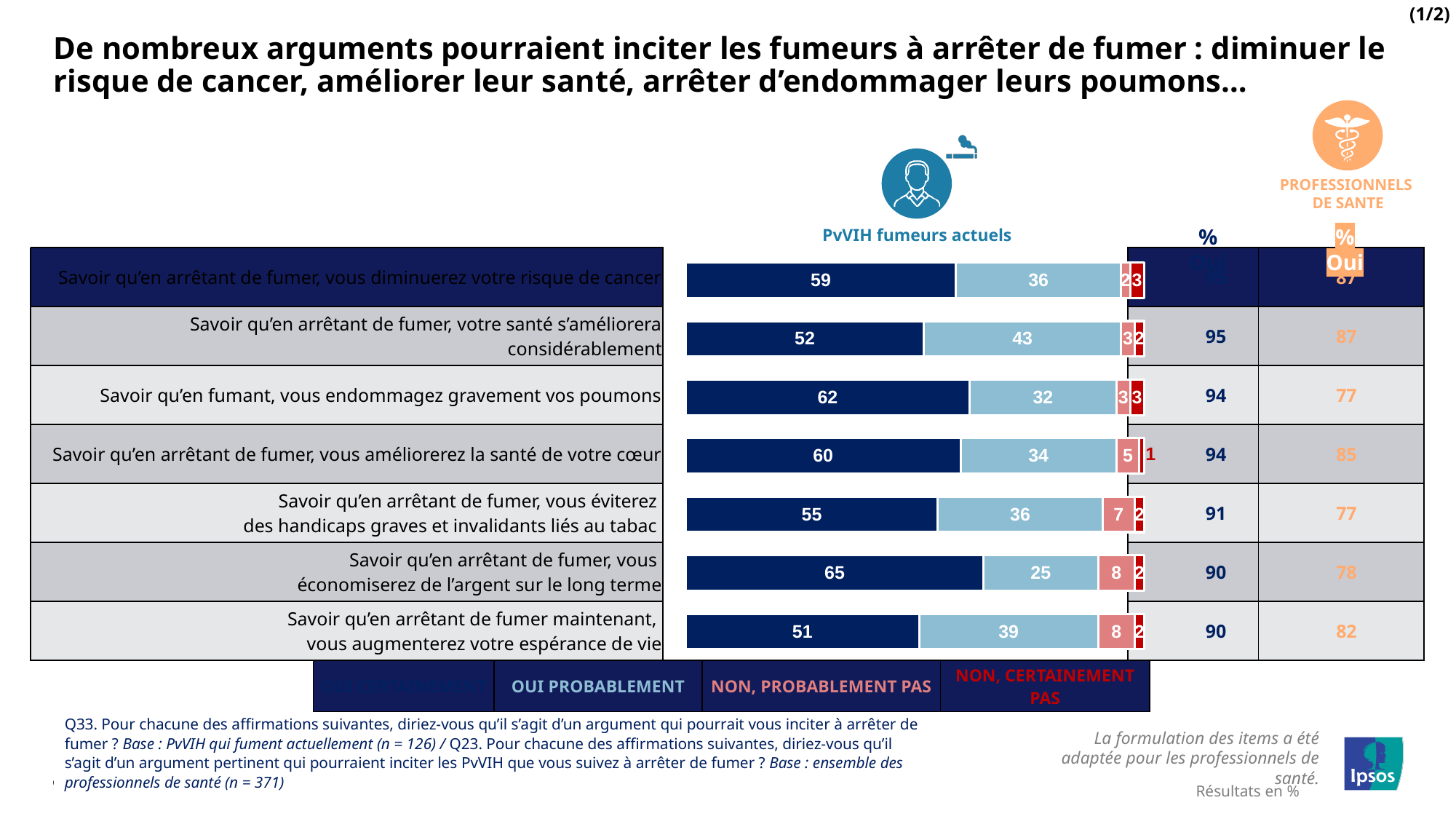
What is the 'Non, probablement pas' value for 'Savoir qu'en arrêtant de fumer, vous éviterez des handicaps graves et invalidants liés au tabac'? 7 What kind of chart is shown on the slide? Stacked bar chart Which statement has the lowest 'Oui certainement' value? Savoir qu'en arrêtant de fumer maintenant, vous augmenterez votre espérance de vie What is the 'Oui certainement' value for 'Savoir qu'en arrêtant de fumer, vous économiserez de l'argent sur le long terme'? 65 How many series does the legend list? 4 What is the total of the stacked bar for 'Savoir qu'en arrêtant de fumer, vous améliorerez la santé de votre cœur'? 100 How many statements are shown in the chart? 7 Which statement has the highest 'Oui certainement' value? Savoir qu'en arrêtant de fumer, vous économiserez de l'argent sur le long terme What is the difference between the highest and lowest 'Oui certainement' values? 14 What is the 'Oui probablement' value for 'Savoir qu'en arrêtant de fumer, votre santé s'améliorera considérablement'? 43 What is the '% Oui' value for professionnels de santé for 'Savoir qu'en arrêtant de fumer, vous améliorerez la santé de votre cœur'? 85 Which has the larger 'Oui probablement' value: 'vous augmenterez votre espérance de vie' or 'vous endommagez gravement vos poumons'? vous augmenterez votre espérance de vie